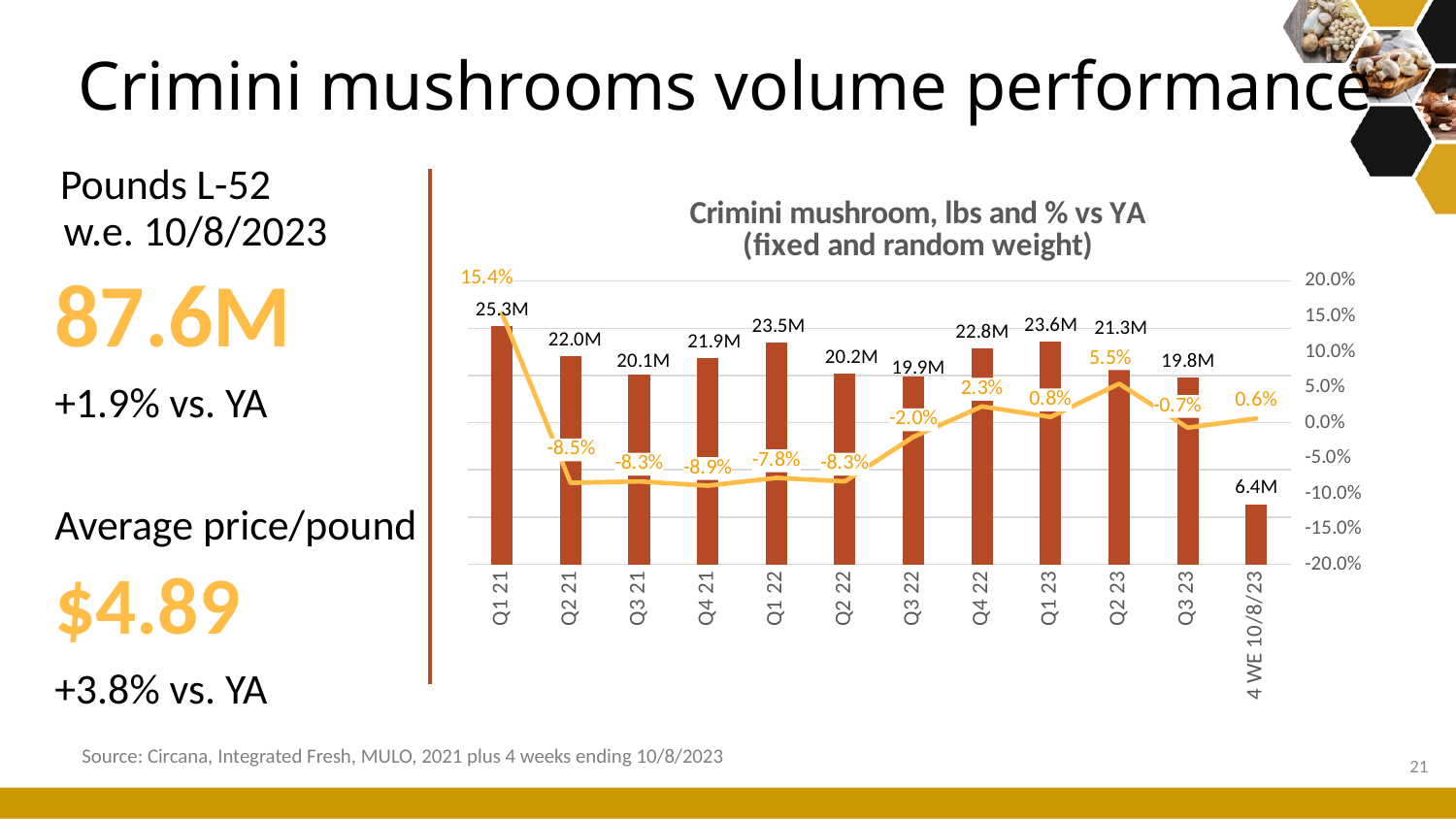
What is the title of the chart? Crimini mushroom, lbs and % vs YA (fixed and random weight) How many periods are shown on the x axis? 12 Is the % vs YA value for Q1 21 greater or less than 10.0%? greater What is the volume in pounds for the 4 WE 10/8/23 period? 6.4M What is the volume in pounds for Q1 21? 25.3M What is the % vs YA value for Q2 23? 5.5% Which period has the highest volume in pounds? Q1 21 What kind of chart is shown? Combination bar and line chart What is the difference in pounds between Q1 23 and Q3 23? 3.8M Does the % vs YA line rise or fall from Q1 21 to Q2 21? Fall Which period has the larger volume in pounds, Q4 22 or Q2 23? Q4 22 Which period has the lowest % vs YA value? Q4 21